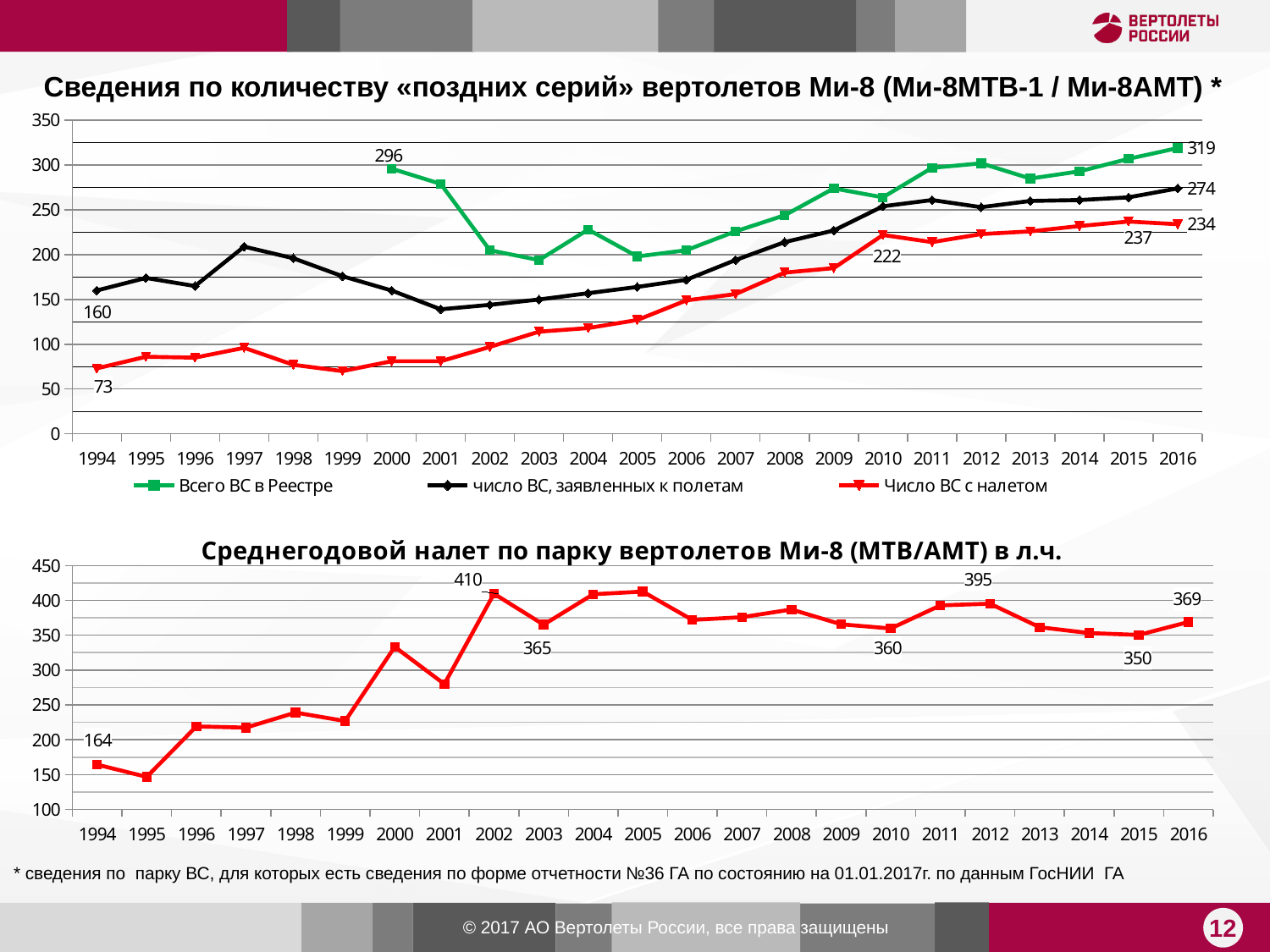
In the top chart, is the value for «Число ВС с налетом» in 1999 greater or less than 100? less In the top chart, what is the value of «Всего ВС в Реестре» in 2016? 319 How many series does the legend of the top chart list? 3 In the bottom chart «Среднегодовой налет по парку вертолетов Ми-8 (МТВ/АМТ) в л.ч.», which year has the larger value, 2010 or 2012? 2012 In the top chart, which series has the highest value in 2016? Всего ВС в Реестре How many years are shown on the x axis of the bottom chart? 23 In the top chart, what is the difference between «Всего ВС в Реестре» and «число ВС, заявленных к полетам» in 2016? 45 In the bottom chart «Среднегодовой налет по парку вертолетов Ми-8 (МТВ/АМТ) в л.ч.», what is the difference between the values for 2016 and 2015? 19 In the bottom chart «Среднегодовой налет по парку вертолетов Ми-8 (МТВ/АМТ) в л.ч.», what is the value for 2002? 410 What kind of chart is the top chart? line chart In the top chart, what is the value of «число ВС, заявленных к полетам» in 1994? 160 In the top chart, what is the value of «Число ВС с налетом» in 2010? 222